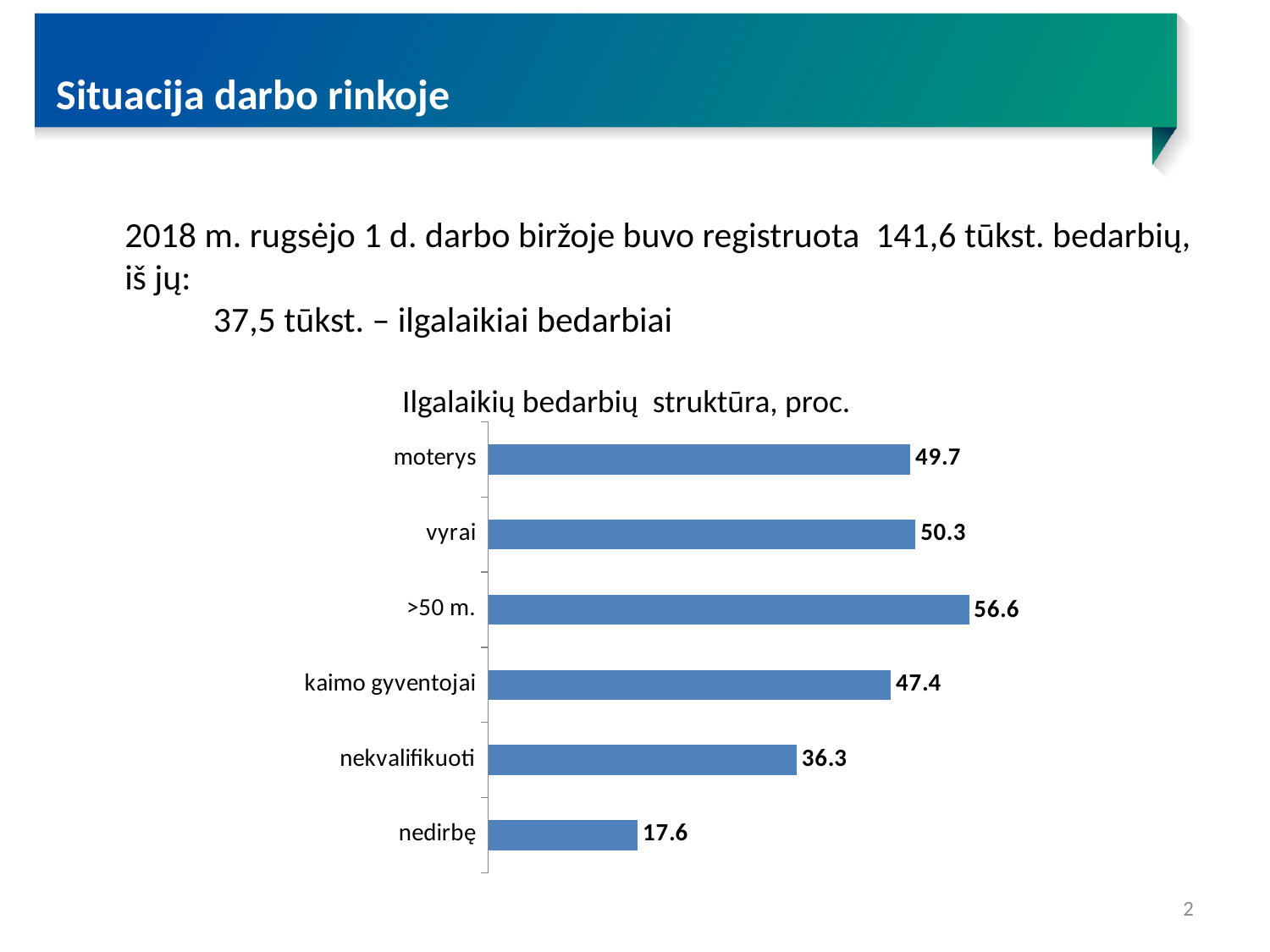
What is the value for "nekvalifikuoti" in the chart? 36.3 What is the value for "kaimo gyventojai" in the chart? 47.4 What is the difference between the values for "vyrai" and "moterys"? 0.6 What kind of chart is shown on the slide? bar chart Which category has the lowest value in the chart? nedirbę Which is larger, the value for "kaimo gyventojai" or the value for "nekvalifikuoti"? kaimo gyventojai What is the value for "nedirbę" in the chart? 17.6 Which category has the highest value in the chart? >50 m. What is the value for ">50 m." in the chart? 56.6 What is the title of the chart? Ilgalaikių bedarbių struktūra, proc. How many categories are shown in the chart? 6 What is the difference between the values for ">50 m." and "nedirbę"? 39.0